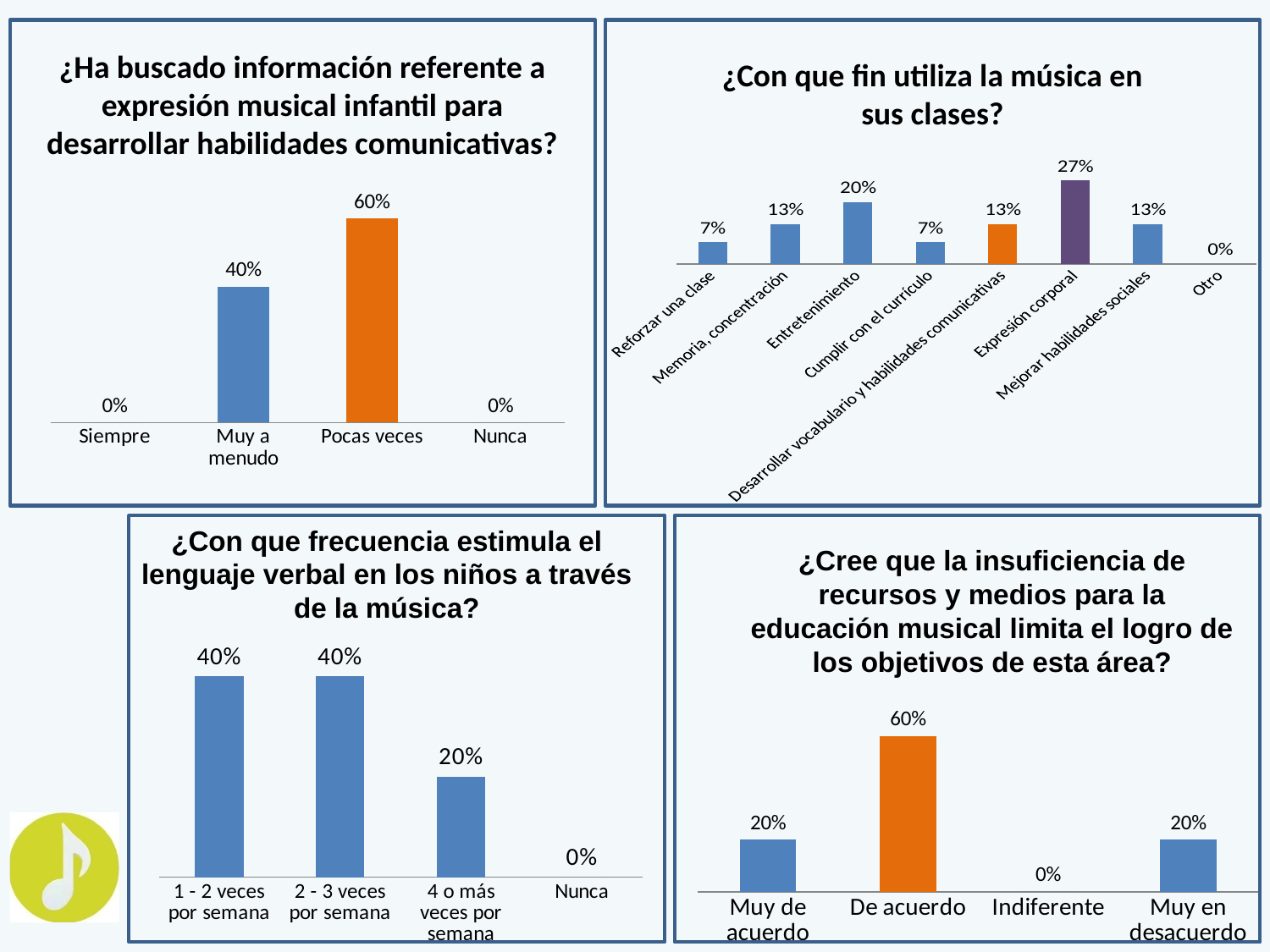
In the bottom-left chart (¿Con que frecuencia estimula el lenguaje verbal...?), what is the value for '4 o más veces por semana'? 20% What type of chart is the bottom-right chart (¿Cree que la insuficiencia de recursos...?)? Bar chart In the top-right chart (¿Con que fin utiliza la música en sus clases?), what is the value for 'Entretenimiento'? 20% In the bottom-right chart (¿Cree que la insuficiencia de recursos...?), what is the value for 'De acuerdo'? 60% In the bottom-right chart (¿Cree que la insuficiencia de recursos...?), which category has the lowest value? Indiferente In the top-left chart (¿Ha buscado información referente a expresión musical infantil...?), what is the value for 'Pocas veces'? 60% In the top-left chart (¿Ha buscado información referente a expresión musical infantil...?), what is the difference between 'Pocas veces' and 'Muy a menudo'? 20% In the top-right chart (¿Con que fin utiliza la música en sus clases?), how many categories are shown on the x axis? 8 In the bottom-left chart (¿Con que frecuencia estimula el lenguaje verbal...?), which is larger: '2 - 3 veces por semana' or '4 o más veces por semana'? 2 - 3 veces por semana In the top-right chart (¿Con que fin utiliza la música en sus clases?), which category has the highest value? Expresión corporal In the top-right chart (¿Con que fin utiliza la música en sus clases?), what is the value for 'Otro'? 0% In the top-left chart (¿Ha buscado información referente a expresión musical infantil...?), which category has the highest value? Pocas veces